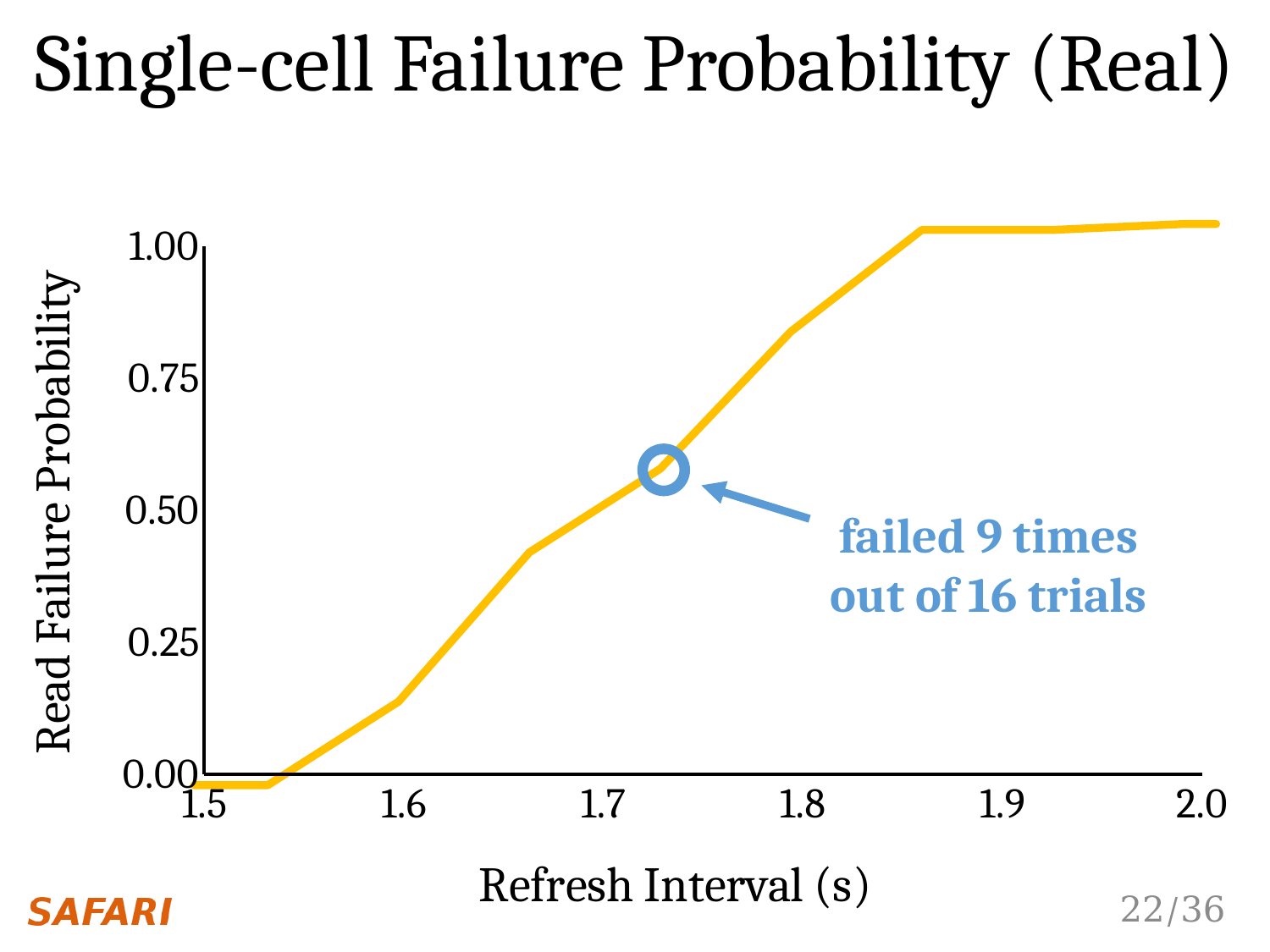
Is the read failure probability at a refresh interval of 1.8 s greater or less than 0.75? greater What kind of chart is shown on the slide? line chart Which refresh interval has the higher read failure probability, 1.6 s or 1.8 s? 1.8 s Is the read failure probability at a refresh interval of 1.7 s greater or less than 0.25? greater Is the read failure probability at a refresh interval of 1.6 s greater or less than 0.25? less Which refresh interval has the lower read failure probability, 1.7 s or 1.9 s? 1.7 s According to the annotation, how many trials failed out of 16 at the circled point? 9 What is the label of the x axis? Refresh Interval (s) What is the title of the chart on the slide? Single-cell Failure Probability (Real) Does the read failure probability rise or fall as the refresh interval increases from 1.5 s to 1.9 s? rise